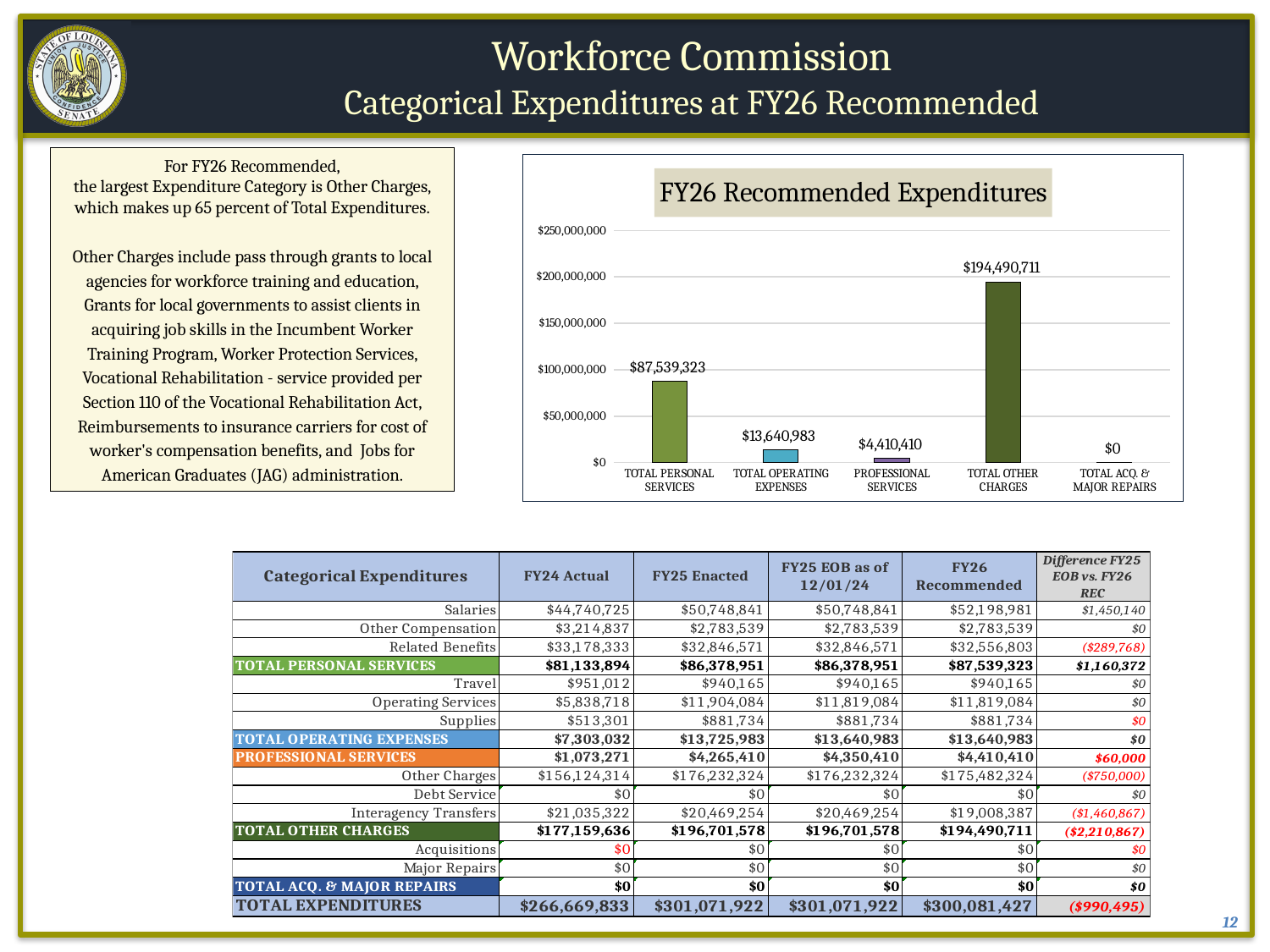
What is the difference between Total Other Charges and Total Personal Services? $106,951,388 What is the title of the chart? FY26 Recommended Expenditures How many expenditure categories are plotted in the chart? 5 What is the value shown for Total Operating Expenses? $13,640,983 Which category has the highest value in the chart? Total Other Charges What is the value shown for Total Personal Services? $87,539,323 What type of chart is shown on the slide? Bar chart Which category has the lowest value in the chart? Total Acq. & Major Repairs What is the value shown for Professional Services? $4,410,410 Is the value for Total Personal Services greater or less than $100,000,000? less Which is larger, Total Operating Expenses or Professional Services? Total Operating Expenses What is the value shown for Total Other Charges? $194,490,711